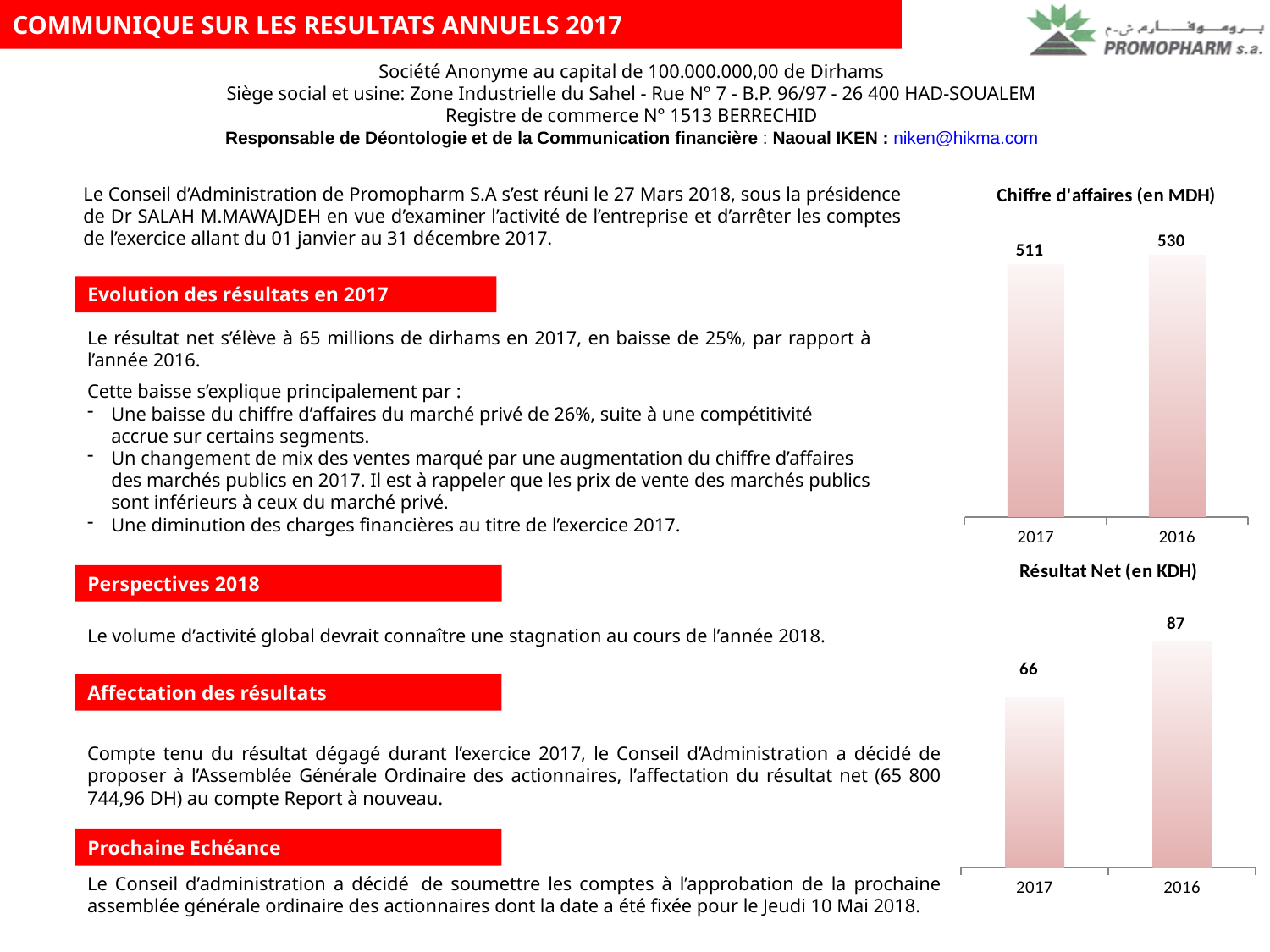
What kind of chart is the 'Résultat Net (en KDH)' chart? bar chart What is the title of the upper chart on the right side of the slide? Chiffre d'affaires (en MDH) In the 'Résultat Net (en KDH)' chart, is the value for 2017 larger or smaller than the value for 2016? smaller In the 'Chiffre d'affaires (en MDH)' chart, which year has the higher value? 2016 In the 'Résultat Net (en KDH)' chart, what is the value for 2017? 66 In the 'Chiffre d'affaires (en MDH)' chart, what is the value for 2017? 511 In the 'Résultat Net (en KDH)' chart, what is the difference between the 2016 and 2017 values? 21 In the 'Chiffre d'affaires (en MDH)' chart, how many categories are shown on the x axis? 2 In the 'Chiffre d'affaires (en MDH)' chart, what is the value for 2016? 530 In the 'Chiffre d'affaires (en MDH)' chart, what is the difference between the 2016 and 2017 values? 19 In the 'Résultat Net (en KDH)' chart, what is the value for 2016? 87 In the 'Résultat Net (en KDH)' chart, which year has the lower value? 2017